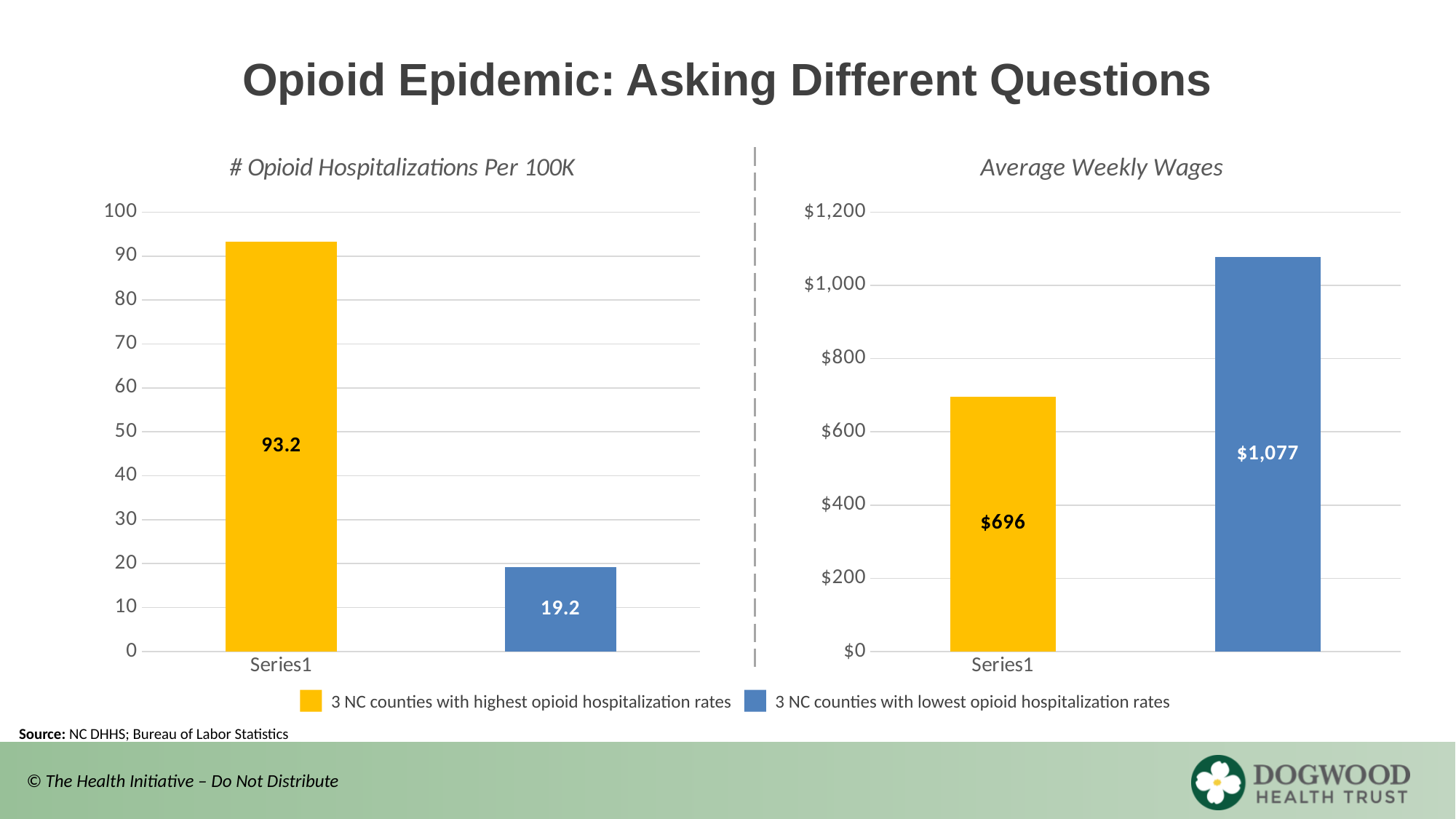
In the 'Average Weekly Wages' chart, is the value for the 3 NC counties with lowest opioid hospitalization rates greater or less than $1,000? greater In the '# Opioid Hospitalizations Per 100K' chart, what is the value for the 3 NC counties with highest opioid hospitalization rates? 93.2 In the 'Average Weekly Wages' chart, what is the difference between the two bars? $381 In the '# Opioid Hospitalizations Per 100K' chart, which group has the lower value? 3 NC counties with lowest opioid hospitalization rates In the 'Average Weekly Wages' chart, what is the value for the 3 NC counties with lowest opioid hospitalization rates? $1,077 In the '# Opioid Hospitalizations Per 100K' chart, what is the difference between the two bars? 74 In the 'Average Weekly Wages' chart, what is the value for the 3 NC counties with highest opioid hospitalization rates? $696 How many series does the legend list? 2 What colour is the bar for the 3 NC counties with highest opioid hospitalization rates? yellow In the 'Average Weekly Wages' chart, which group has the higher average weekly wage? 3 NC counties with lowest opioid hospitalization rates In the '# Opioid Hospitalizations Per 100K' chart, what is the value for the 3 NC counties with lowest opioid hospitalization rates? 19.2 What kind of chart is the 'Average Weekly Wages' chart? bar chart